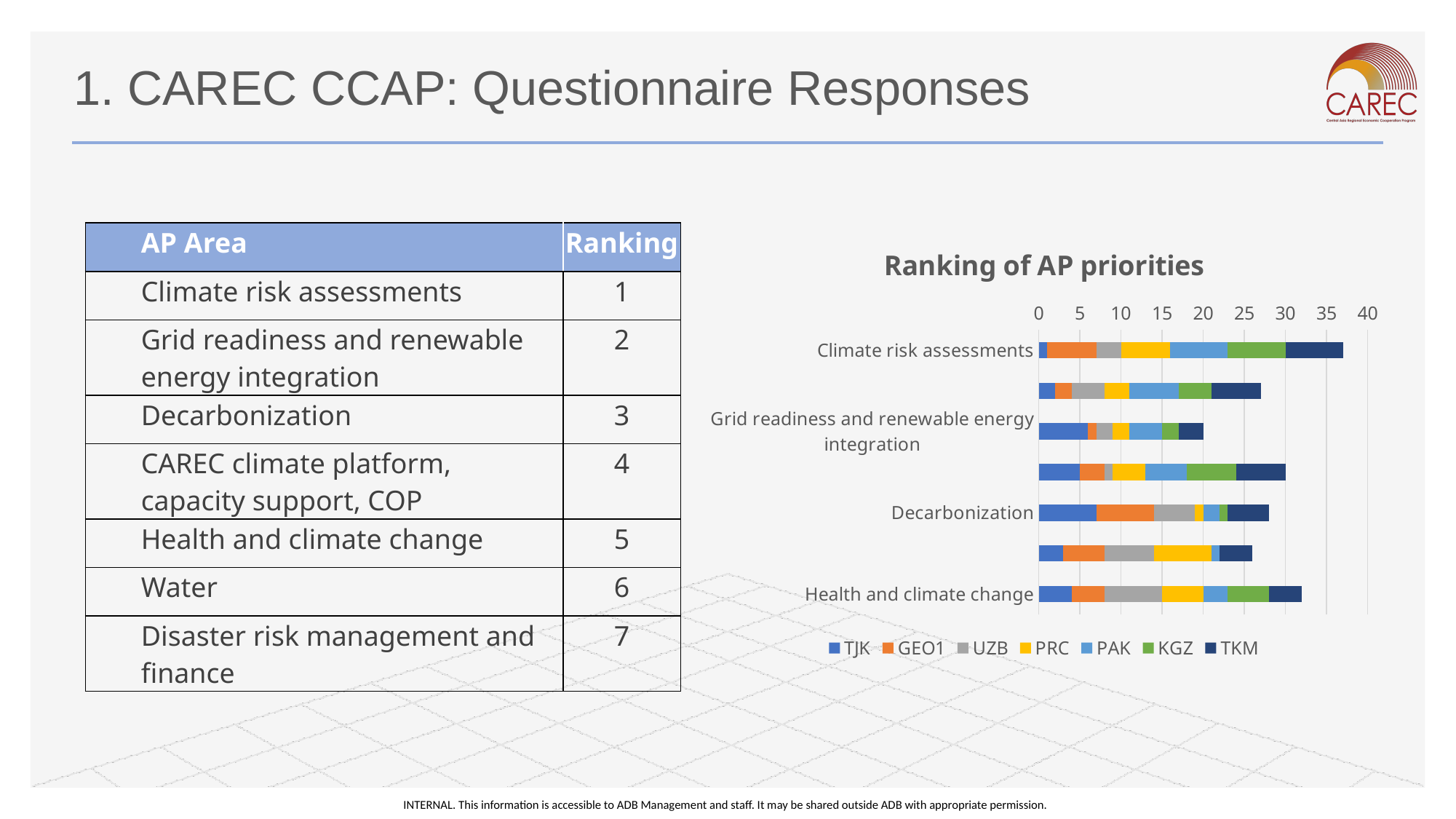
Which series are listed in the chart legend? TJK, GEO1, UZB, PRC, PAK, KGZ, TKM Is the total bar length for Decarbonization greater or less than 25? greater Is the total bar length for Climate risk assessments greater or less than 35? greater Is the total bar length for Health and climate change greater or less than 25? greater What kind of chart is shown on the slide? Stacked bar chart How many bars are plotted in the chart? 7 Which category has the longest bar in the chart? Climate risk assessments Which bar is longer: Health and climate change or Grid readiness and renewable energy integration? Health and climate change How many series does the chart legend list? 7 Which bar is longer: Climate risk assessments or Decarbonization? Climate risk assessments What is the title of the chart? Ranking of AP priorities